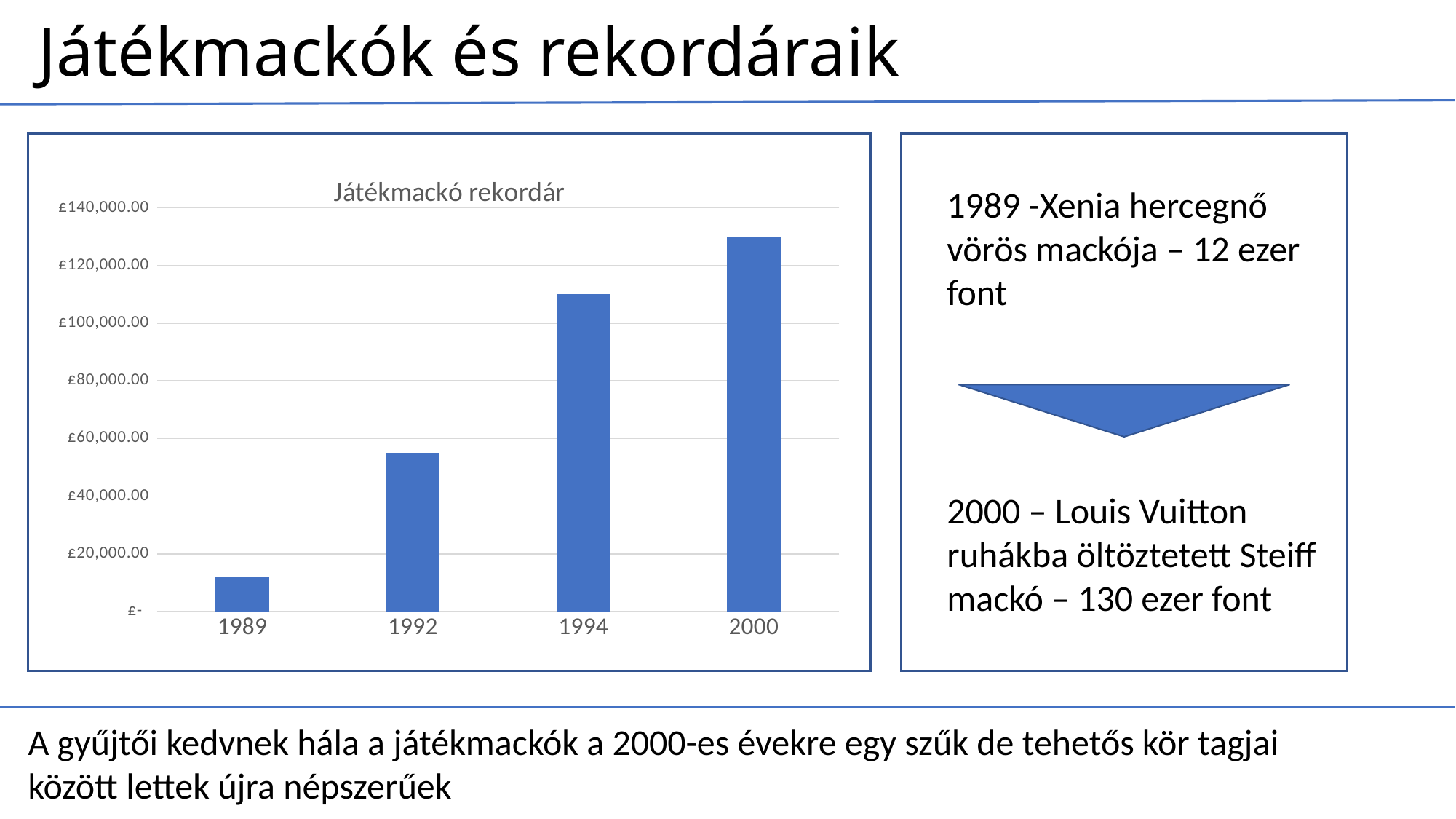
How many years are shown on the x axis of the chart? 4 Which is larger, the value for 1992 or the value for 1994? 1994 Which year has the lowest bar in the chart? 1989 Is the value for 2000 greater or less than £120,000.00? greater Do the values rise or fall from 1989 to 2000 along the x axis? rise Which year has the highest bar in the chart? 2000 What is the title of the chart? Játékmackó rekordár Is the value for 1992 greater or less than £60,000.00? less What type of chart is shown on the slide? bar chart Is the value for 1994 greater or less than £100,000.00? greater What is the highest value shown on the y axis of the chart? £140,000.00